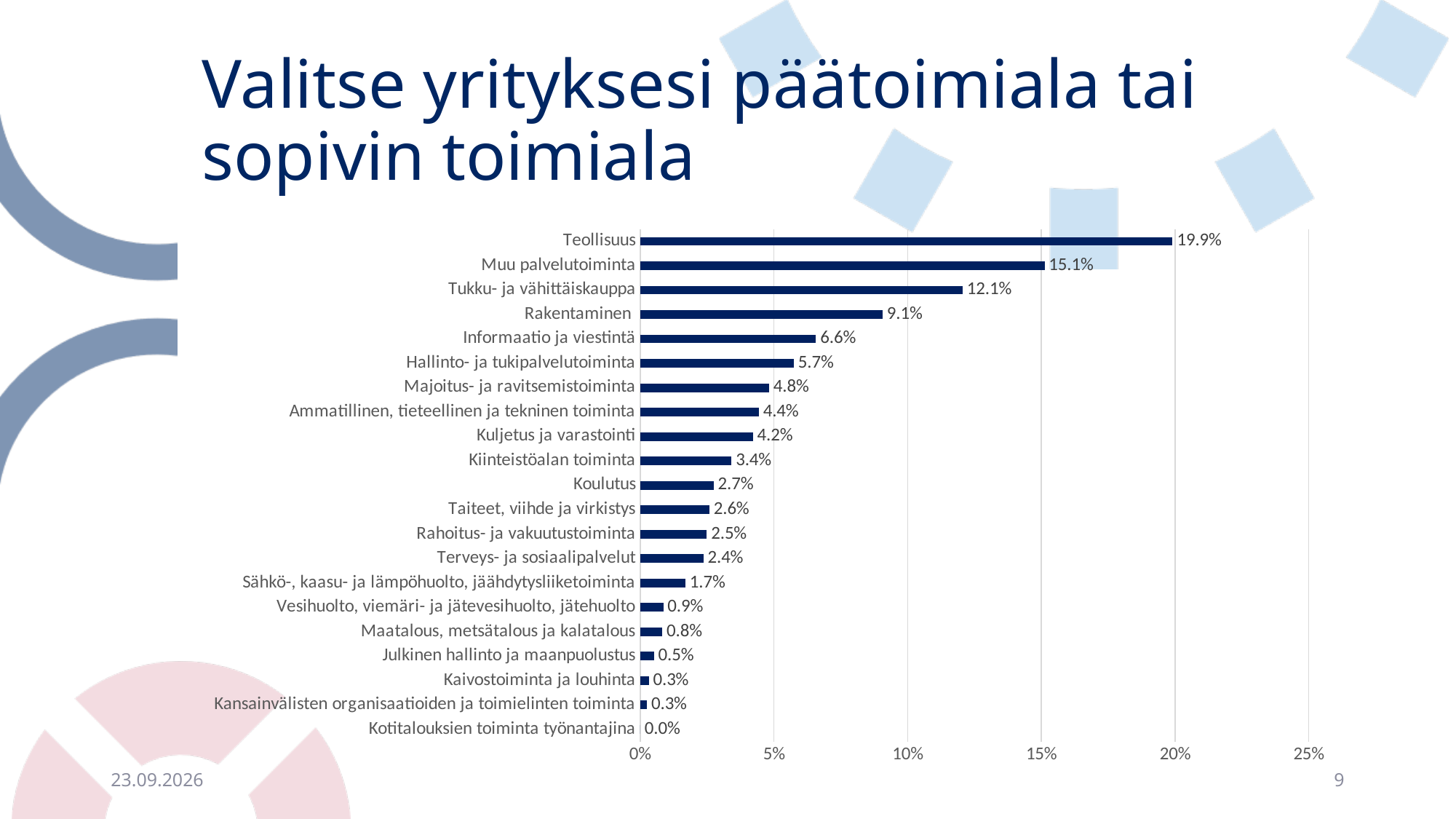
What is the difference between Tukku- ja vähittäiskauppa and Rakentaminen? 3.0% What kind of chart is shown on the slide? Bar chart What is the value for Teollisuus? 19.9% Which category has the lowest value? Kotitalouksien toiminta työnantajina What is the value for Kuljetus ja varastointi? 4.2% Which category has the highest value? Teollisuus Is the value for Muu palvelutoiminta greater or less than 10%? greater What is the value for Rakentaminen? 9.1% Which is larger, Informaatio ja viestintä or Hallinto- ja tukipalvelutoiminta? Informaatio ja viestintä What is the difference between Teollisuus and Muu palvelutoiminta? 4.8% What is the value for Koulutus? 2.7% How many categories are shown in the chart? 21